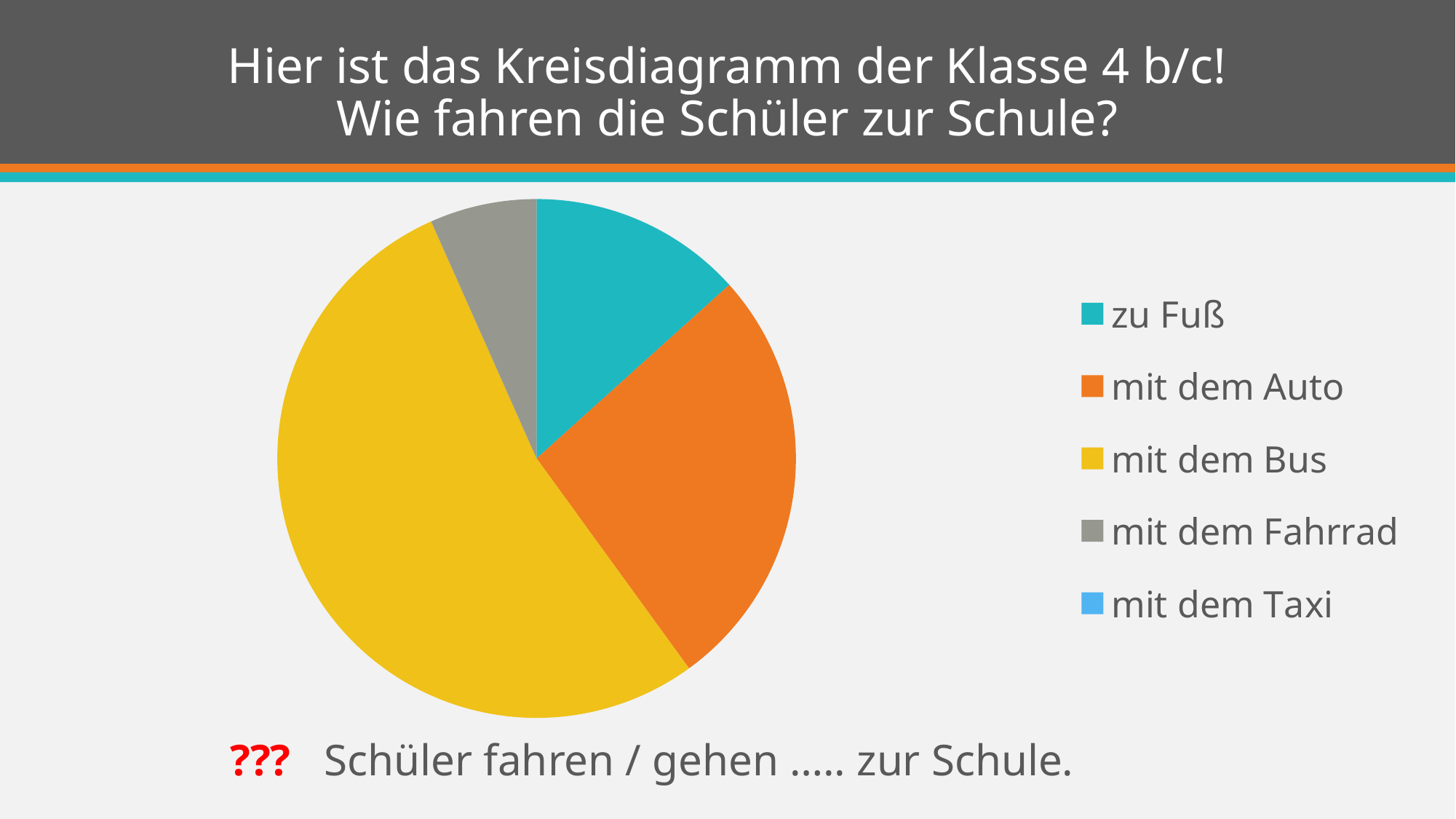
Which is larger, the slice for mit dem Auto or the slice for zu Fuß? mit dem Auto What kind of chart is shown on the slide? pie chart Which is larger, the slice for mit dem Bus or the slice for mit dem Auto? mit dem Bus Which colour is used for the mit dem Bus slice? yellow Is the share of the pie for mit dem Fahrrad greater or less than 25%? less Is the share of the pie for mit dem Bus greater or less than 50%? greater How many entries does the legend list? 5 Which category has the largest slice of the pie? mit dem Bus Which legend entry has no visible slice in the pie? mit dem Taxi Which is larger, the slice for zu Fuß or the slice for mit dem Fahrrad? zu Fuß